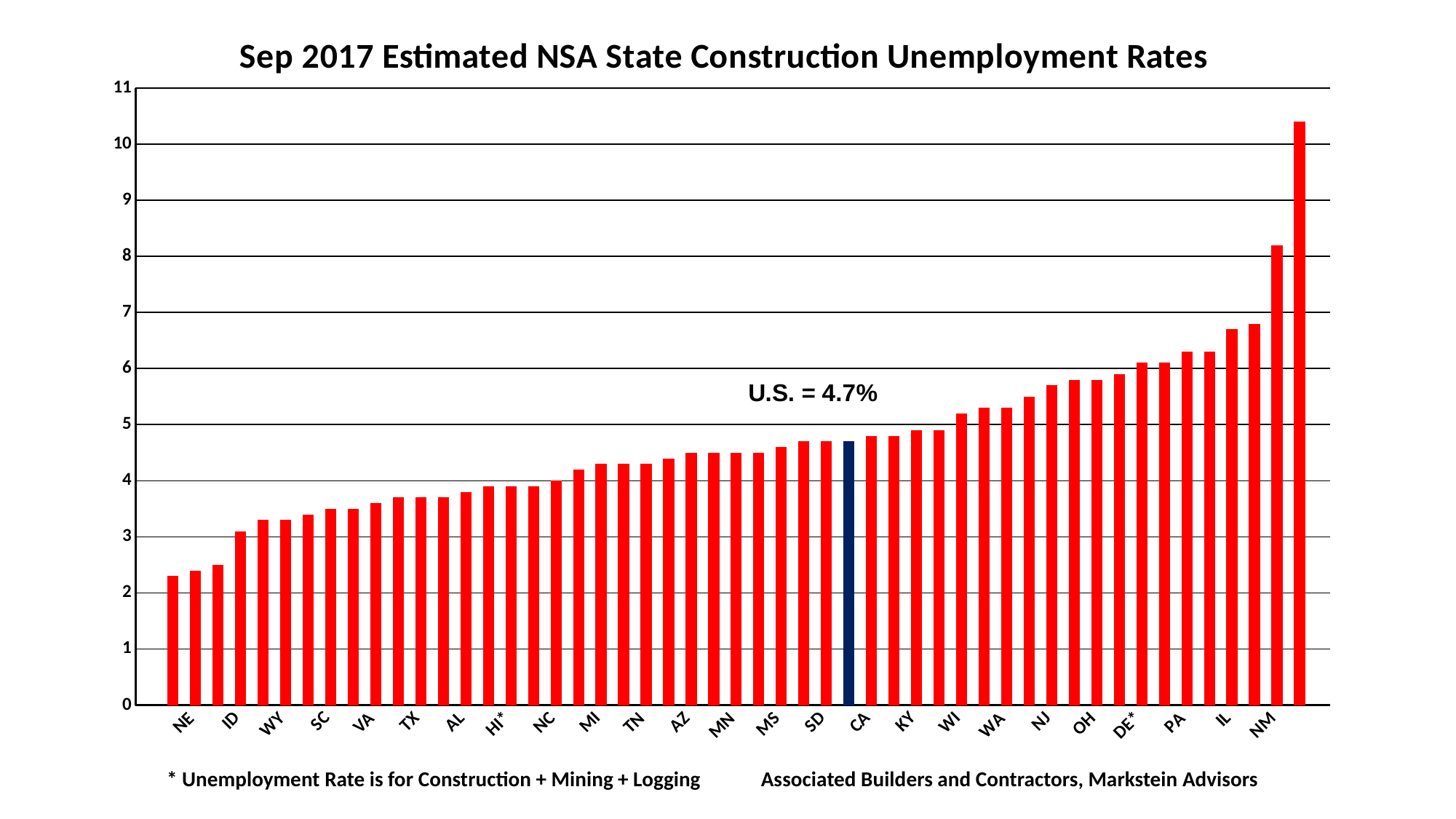
Is the value for IL greater or less than 6? greater Which bar is shown in a different colour (dark blue) from the others? U.S. What kind of chart is shown on the slide? bar chart Do the bar values rise or fall moving from left to right along the x axis? rise Which has the higher construction unemployment rate, ID or PA? PA Is the value for NM greater or less than 7? greater Is the value for NE greater or less than 3? less What is the title of the chart? Sep 2017 Estimated NSA State Construction Unemployment Rates What is the U.S. construction unemployment rate shown on the chart? 4.7% Which has the higher construction unemployment rate, NE or NM? NM